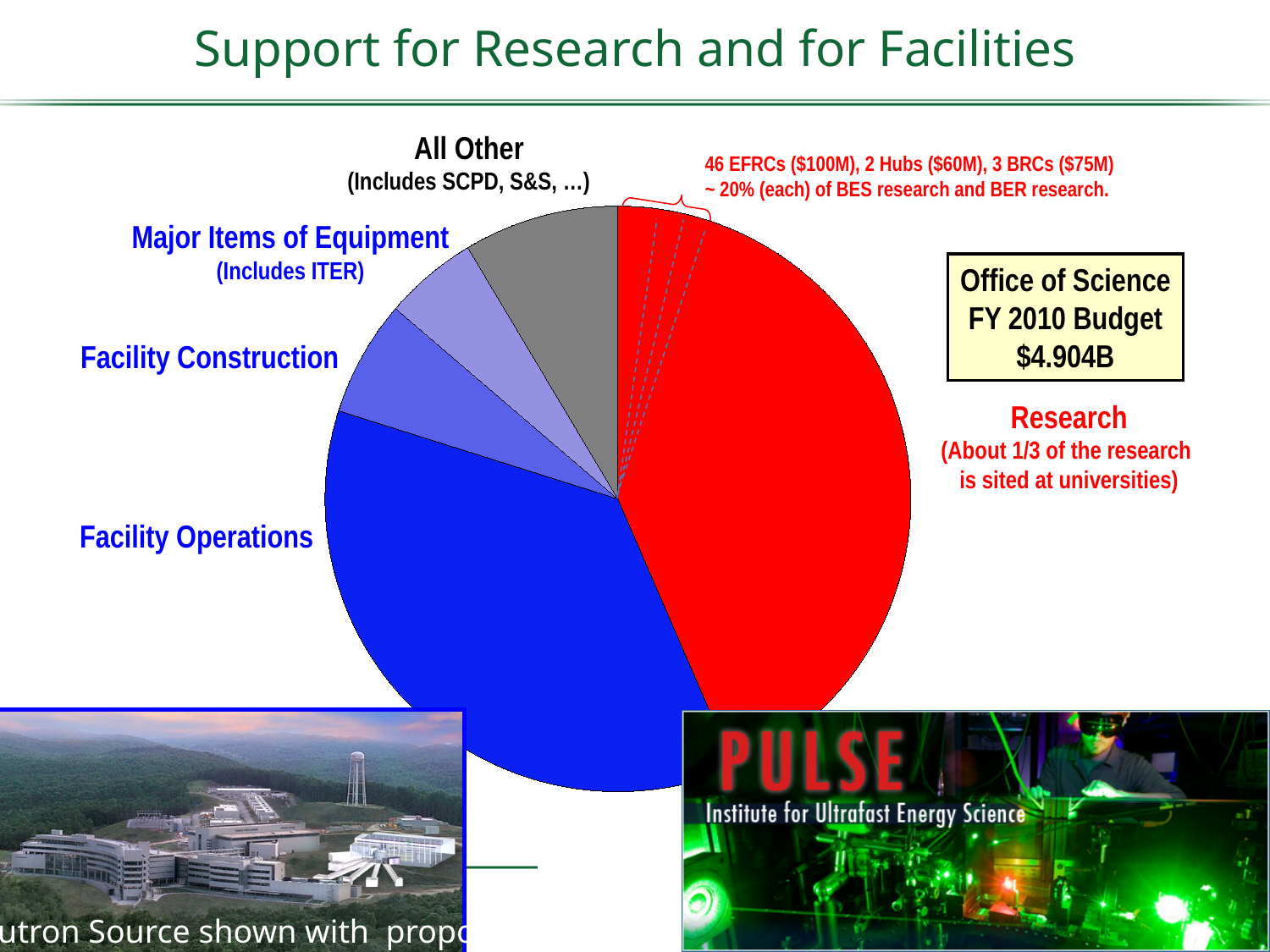
What kind of chart is shown on the slide? pie chart Which slice is larger, Facility Operations or Facility Construction? Facility Operations Which slice is larger, Research or Facility Operations? Research Which slice is larger, Facility Operations or Major Items of Equipment? Facility Operations What total Office of Science FY 2010 budget does the slide state for the pie chart? $4.904B How many slices does the pie chart have? 5 What is the title of the slide containing the pie chart? Support for Research and for Facilities Which category has the largest slice of the pie chart? Research